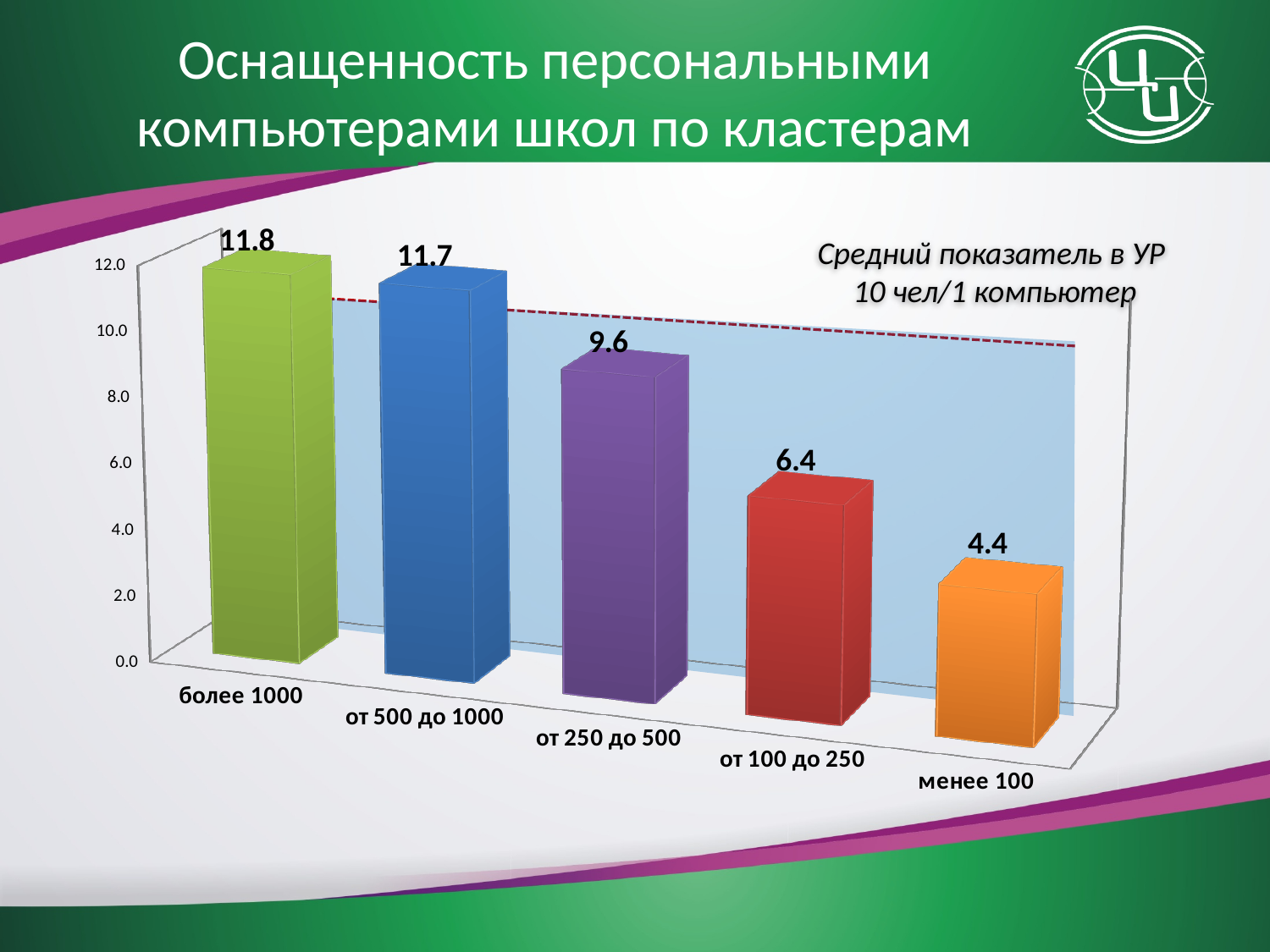
What is the difference between the values for 'от 500 до 1000' and 'от 100 до 250'? 5.3 What is the value for the 'менее 100' cluster? 4.4 What kind of chart is shown on the slide? bar chart Which cluster has the lowest value? менее 100 Is the value for 'от 100 до 250' greater or less than 8.0? less Which is larger, the value for 'от 250 до 500' or the value for 'от 100 до 250'? от 250 до 500 Which cluster has the highest value? более 1000 What is the value for the 'более 1000' cluster? 11.8 Do the values rise or fall from left to right along the x axis? fall What is the value for the 'от 250 до 500' cluster? 9.6 How many clusters are shown on the chart? 5 What average indicator for UR is stated on the slide? 10 чел/1 компьютер